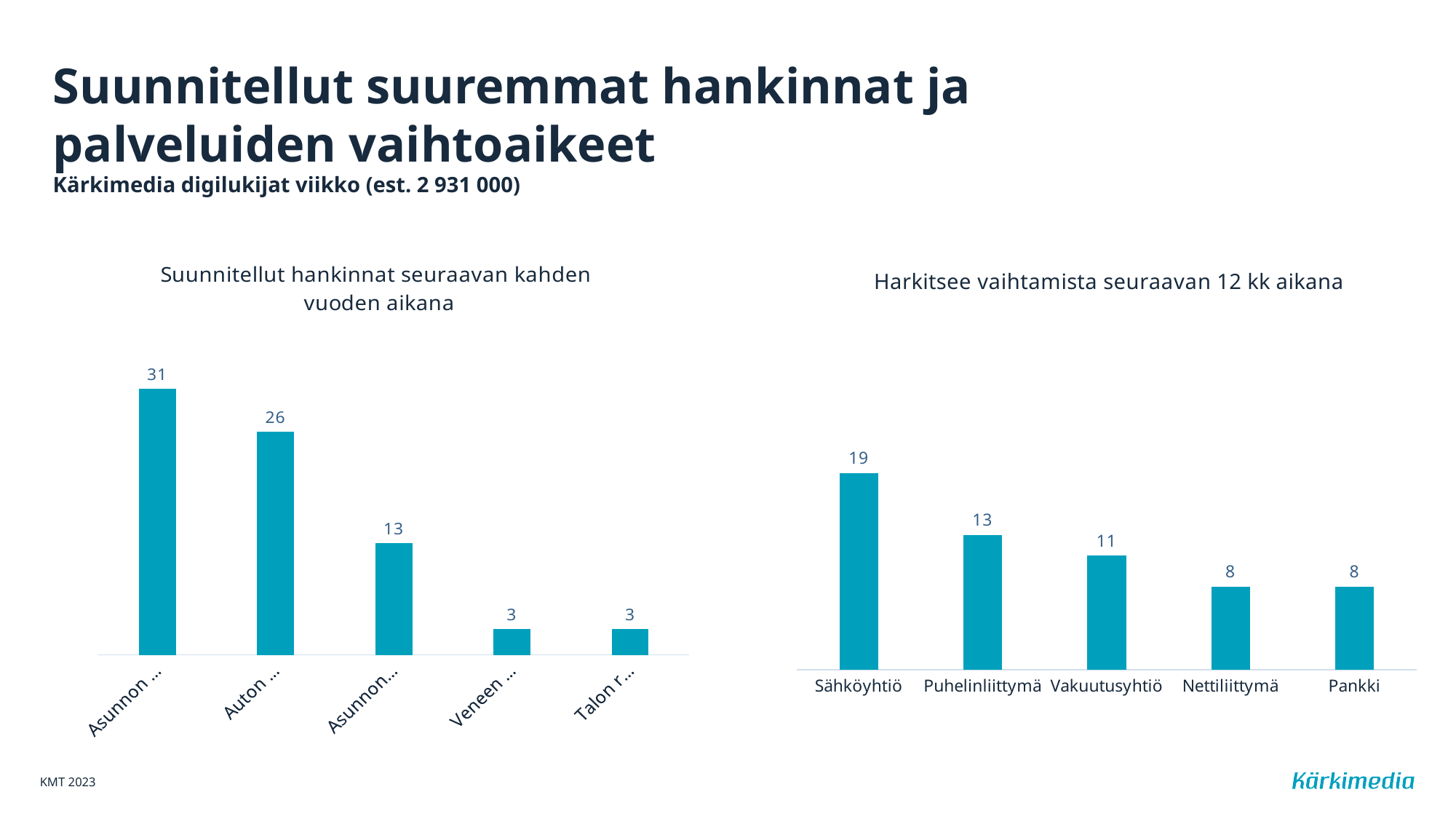
In the chart titled "Harkitsee vaihtamista seuraavan 12 kk aikana", how many categories are shown? 5 In the chart titled "Harkitsee vaihtamista seuraavan 12 kk aikana", which category has the highest value? Sähköyhtiö In the chart titled "Harkitsee vaihtamista seuraavan 12 kk aikana", do the values rise or fall from left to right? fall What type of chart is the chart titled "Suunnitellut hankinnat seuraavan kahden vuoden aikana"? bar chart In the chart titled "Suunnitellut hankinnat seuraavan kahden vuoden aikana", how many bars are shown? 5 In the chart titled "Harkitsee vaihtamista seuraavan 12 kk aikana", what is the value for Sähköyhtiö? 19 In the chart titled "Suunnitellut hankinnat seuraavan kahden vuoden aikana", what is the difference between the first bar and the second bar? 5 In the chart titled "Harkitsee vaihtamista seuraavan 12 kk aikana", which is larger, Puhelinliittymä or Vakuutusyhtiö? Puhelinliittymä In the chart titled "Harkitsee vaihtamista seuraavan 12 kk aikana", what is the value for Vakuutusyhtiö? 11 In the chart titled "Harkitsee vaihtamista seuraavan 12 kk aikana", what is the difference between Sähköyhtiö and Puhelinliittymä? 6 In the chart titled "Suunnitellut hankinnat seuraavan kahden vuoden aikana", what is the value of the first (leftmost) bar? 31 In the chart titled "Suunnitellut hankinnat seuraavan kahden vuoden aikana", what is the value for the category labelled "Auton ..."? 26